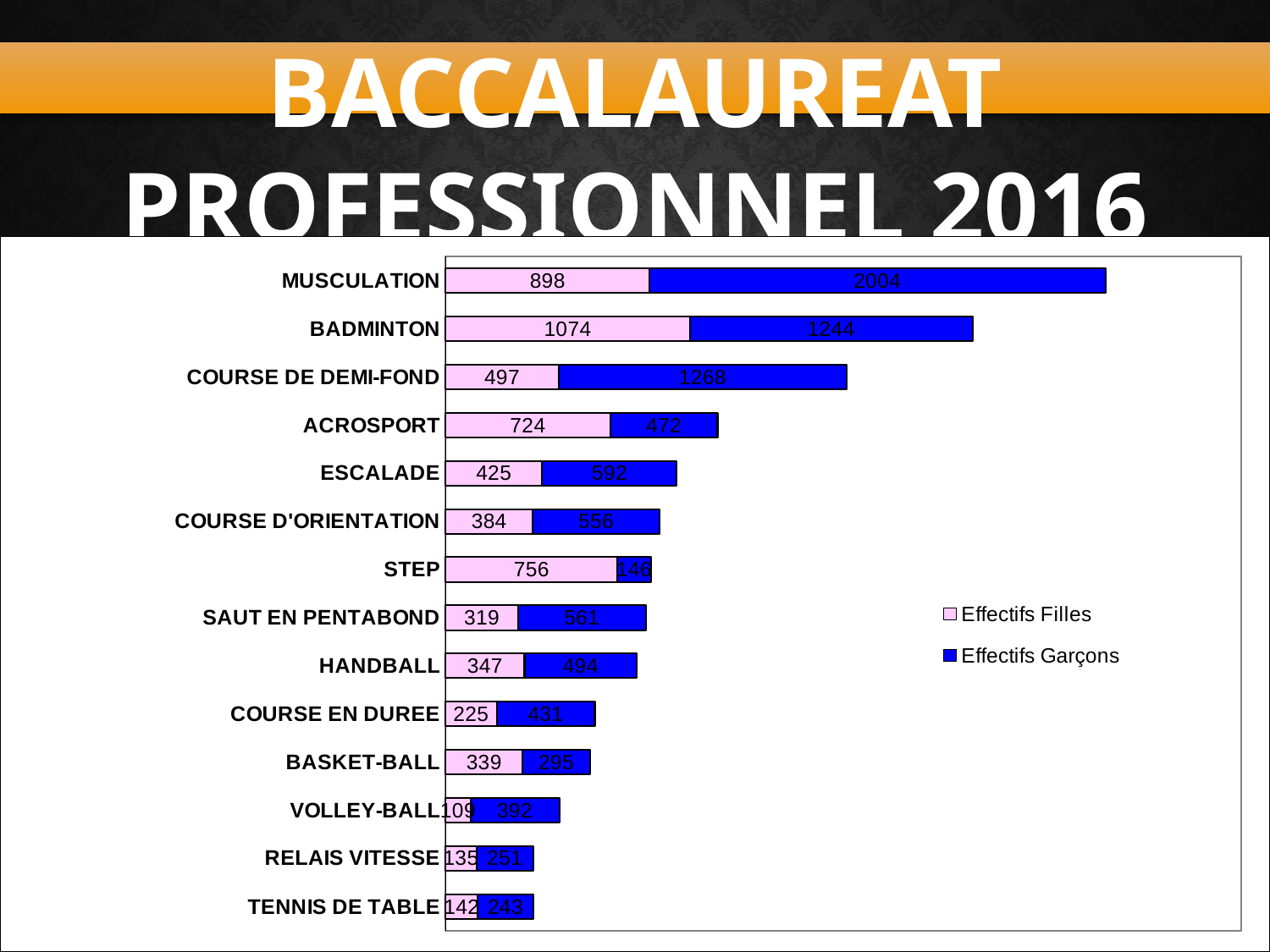
What is the Effectifs Garçons value for MUSCULATION? 2004 What is the total of the stacked bar for BADMINTON? 2318 What is the difference between Effectifs Garçons and Effectifs Filles for MUSCULATION? 1106 Which category has the highest Effectifs Garçons value? MUSCULATION How many series does the legend list? 2 What is the Effectifs Filles value for BADMINTON? 1074 How many categories are shown on the chart? 14 What kind of chart is shown on the slide? Stacked bar chart What is the Effectifs Garçons value for COURSE DE DEMI-FOND? 1268 Which category has the lowest Effectifs Garçons value? STEP Which is larger for ACROSPORT, Effectifs Filles or Effectifs Garçons? Effectifs Filles What is the Effectifs Filles value for STEP? 756